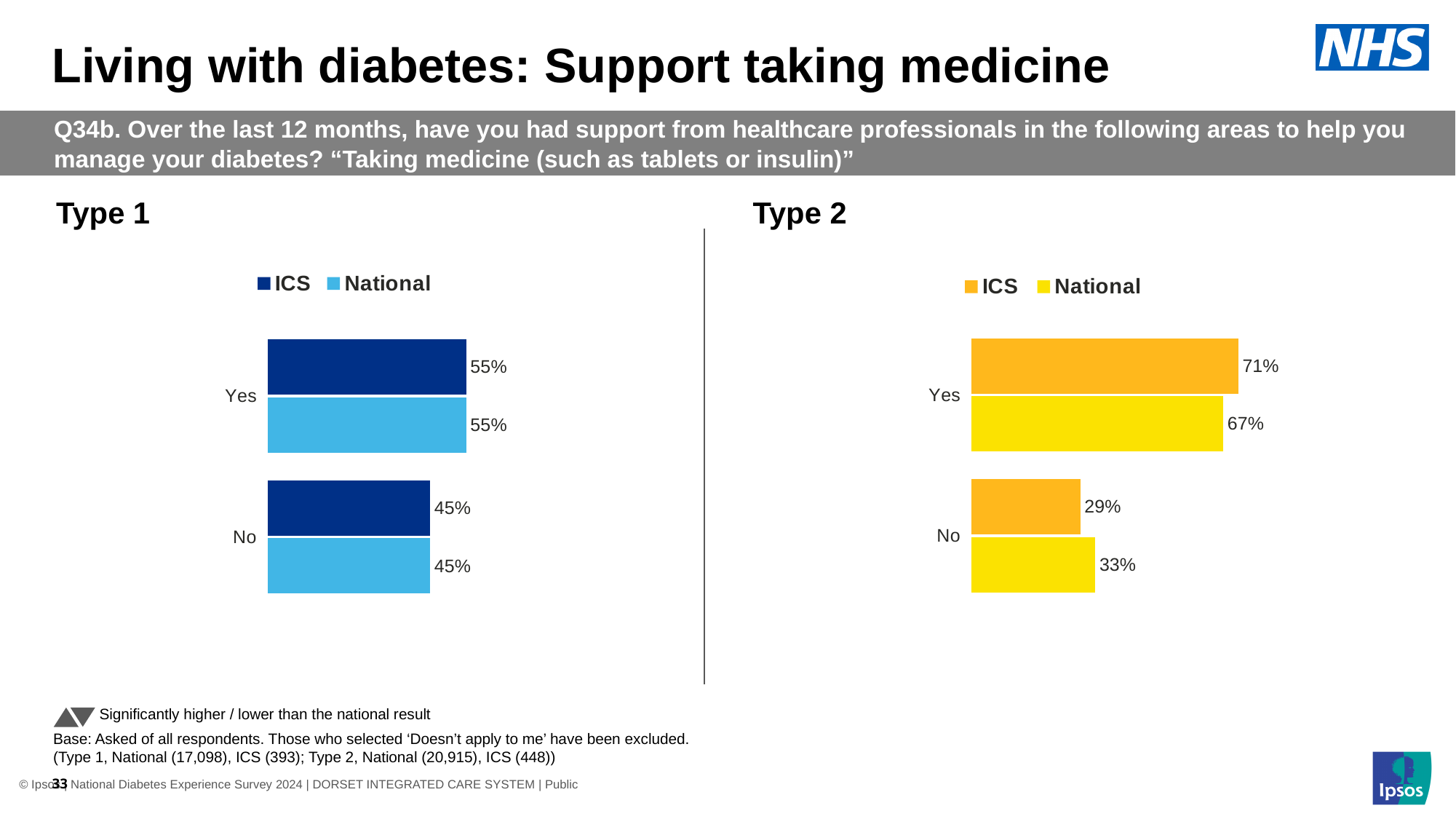
In the Type 1 chart, what is the National value for No? 45% In the Type 2 chart, what is the difference between the ICS and National values for Yes? 4 percentage points In the Type 2 chart, how many series does the legend list? 2 In the Type 1 chart, what is the ICS value for Yes? 55% In the Type 2 chart, what is the difference between the National and ICS values for No? 4 percentage points In the Type 2 chart, which series has the highest value for Yes? ICS In the Type 2 chart, what colour represents the ICS series? Orange What kind of chart is the Type 1 chart? Bar chart In the Type 2 chart, which is larger for No: ICS or National? National In the Type 2 chart, what is the National value for No? 33% In the Type 1 chart, how many categories are shown? 2 In the Type 2 chart, what is the ICS value for Yes? 71%